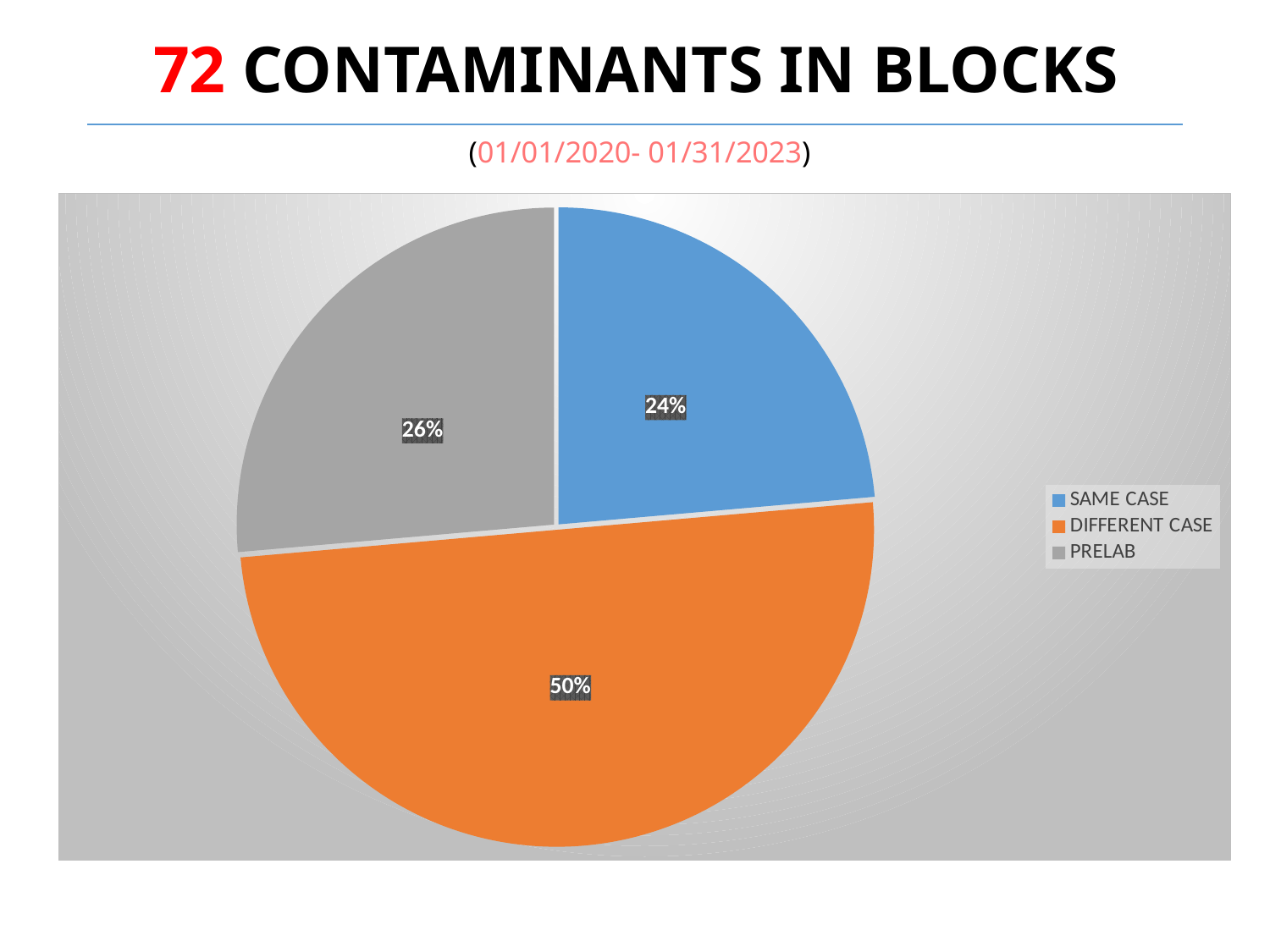
How many entries does the legend list? 3 What percentage of the pie is labelled PRELAB? 26% What kind of chart is shown on the slide? Pie chart What percentage of the pie is labelled DIFFERENT CASE? 50% Which category has the largest slice of the pie? DIFFERENT CASE Which category has the smallest slice of the pie? SAME CASE What colour is the DIFFERENT CASE slice? Orange How many slices does the pie chart have? 3 What is the difference in percentage points between PRELAB and SAME CASE? 2 What percentage of the pie is labelled SAME CASE? 24% What is the difference in percentage points between DIFFERENT CASE and PRELAB? 24 Which is larger, the PRELAB slice or the SAME CASE slice? PRELAB